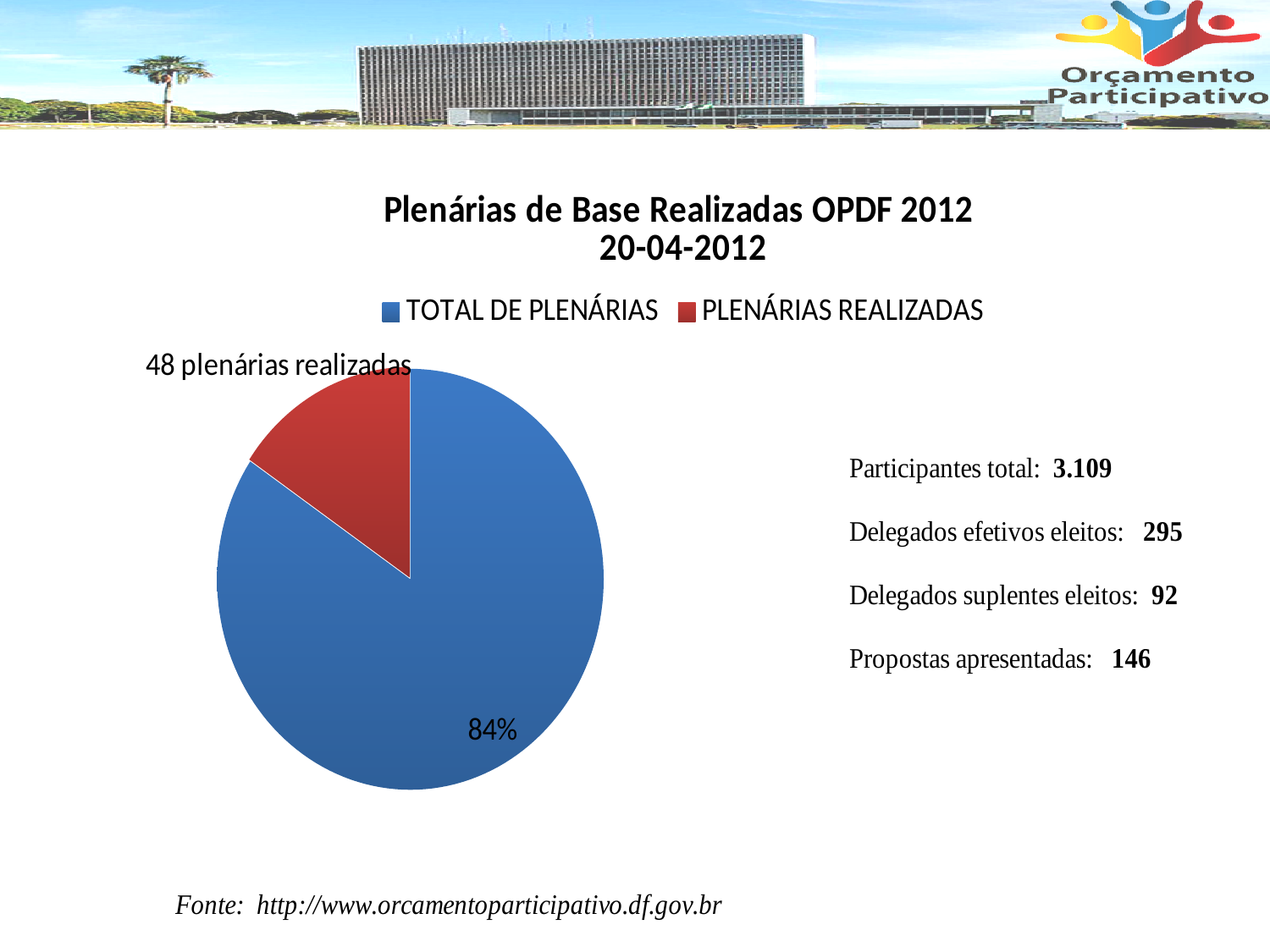
How many series does the legend list? 2 What percentage is printed on the TOTAL DE PLENÁRIAS slice? 84% How many slices does the pie chart have? 2 What is the title of the chart? Plenárias de Base Realizadas OPDF 2012 20-04-2012 What colour is the PLENÁRIAS REALIZADAS slice? red What share of the pie does the TOTAL DE PLENÁRIAS slice represent? 84% Which slice of the pie is the smallest? PLENÁRIAS REALIZADAS Which slice of the pie is the largest? TOTAL DE PLENÁRIAS What label is printed next to the PLENÁRIAS REALIZADAS slice? 48 plenárias realizadas What kind of chart is shown on the slide? pie chart Which is larger, the TOTAL DE PLENÁRIAS slice or the PLENÁRIAS REALIZADAS slice? TOTAL DE PLENÁRIAS